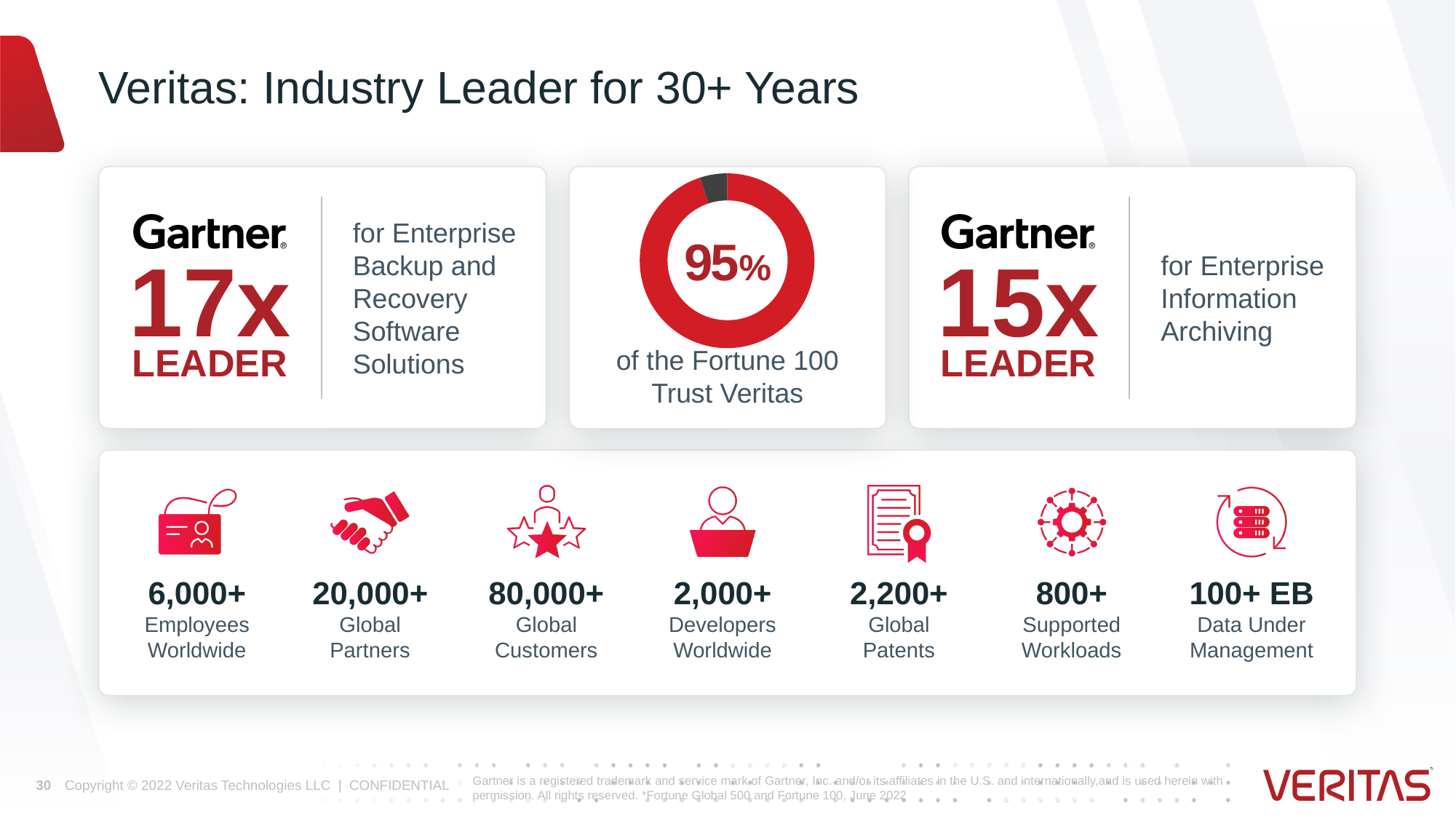
What percentage of the Fortune 100 trust Veritas, according to the donut chart? 95% What colour is the largest segment of the donut chart? Red How many segments does the donut chart have? 2 Is the value shown in the donut chart greater or less than 50%? greater Which segment of the donut chart is larger, the red one or the dark grey one? The red one What group does the donut chart's caption say the 95% refers to? The Fortune 100 What share of the donut chart is filled in red? 95% What kind of chart is shown in the middle card of the top row? Donut chart What share of the donut chart is not filled in red (the dark grey portion)? 5%